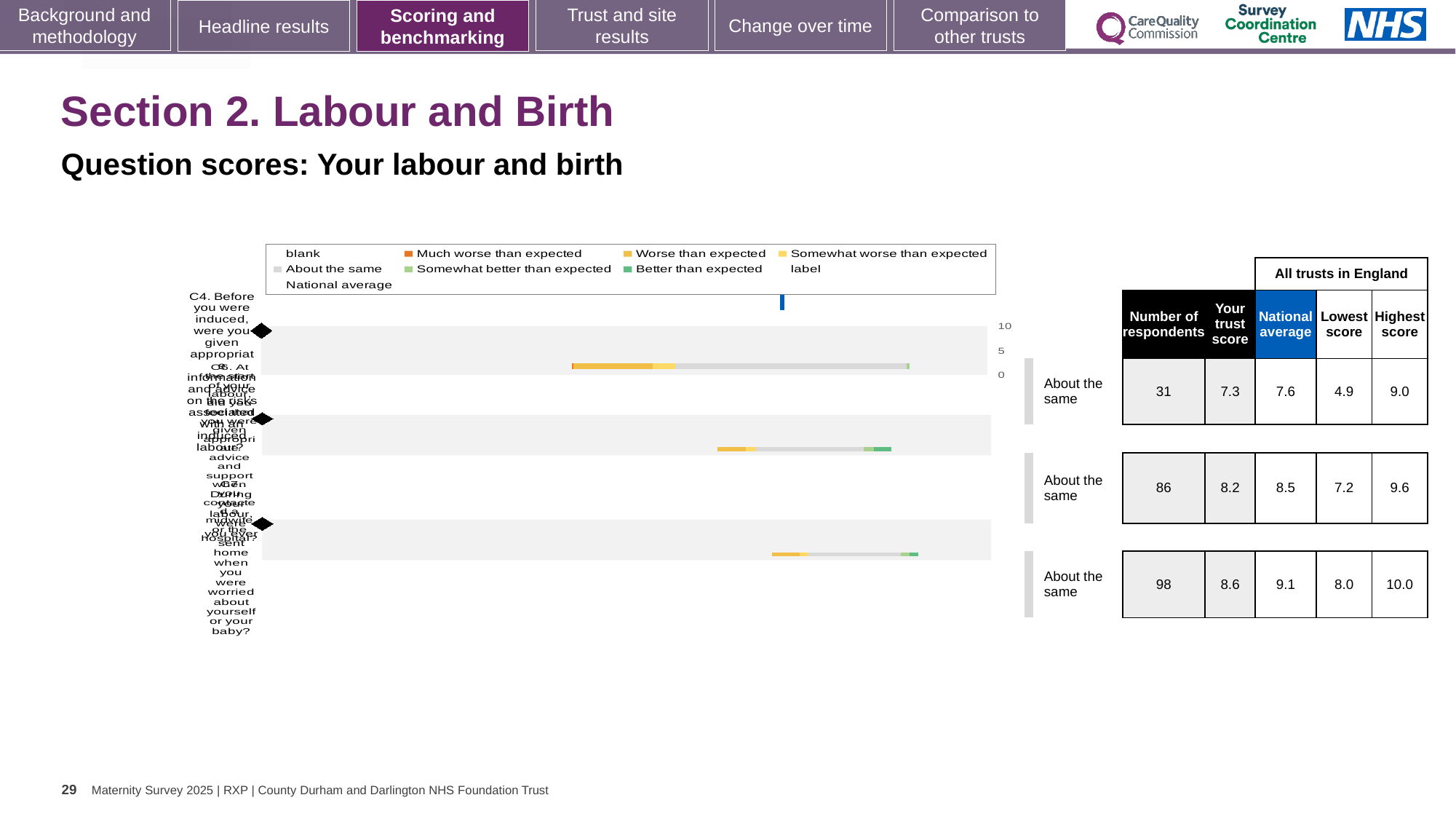
What is the lowest score for the first row (C4) in the table beside the chart? 4.9 How many question rows (bars) are plotted in the chart? 3 What is the national average for the third row (C7) in the table beside the chart? 9.1 What kind of chart is shown on the slide? bar chart What benchmark label is shown next to each of the three rows? About the same For the first row (C4), how much higher is the national average than the trust score? 0.3 Which row has the highest trust score in the table beside the chart? the third row (C7), 8.6 Which legend entry is shown in orange? Much worse than expected In the table beside the chart, what is the number of respondents for the first row (C4)? 31 What is the trust score for the second row (C5) in the table beside the chart? 8.2 What is the highest score for the third row (C7) in the table beside the chart? 10.0 Which is larger: the lowest score for the second row (7.2) or the lowest score for the third row (8.0)? the third row (8.0)